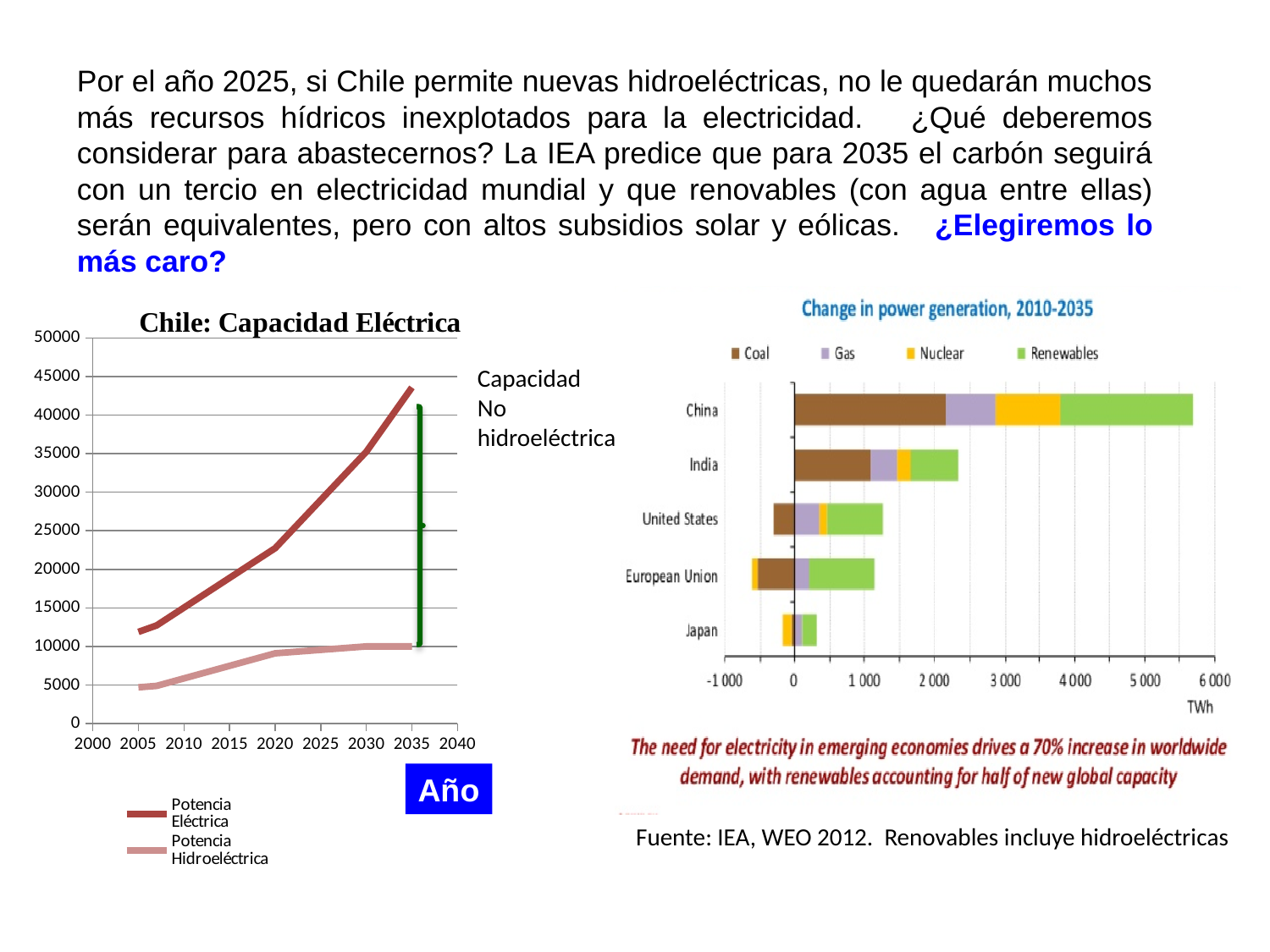
How many series does the legend of the 'Chile: Capacidad Eléctrica' chart list? 2 In the 'Chile: Capacidad Eléctrica' chart, is the value of Potencia Eléctrica in 2035 greater or less than 40000? greater What kind of chart is the 'Change in power generation, 2010-2035' chart? stacked bar chart How many countries or regions are shown in the 'Change in power generation, 2010-2035' chart? 5 In the 'Chile: Capacidad Eléctrica' chart, does Potencia Eléctrica rise or fall from 2005 to 2035? rise What kind of chart is the 'Chile: Capacidad Eléctrica' chart? line chart How many series does the legend of the 'Change in power generation, 2010-2035' chart list? 4 In the 'Change in power generation, 2010-2035' chart, which country or region has the largest total change? China In the 'Chile: Capacidad Eléctrica' chart, is the value of Potencia Hidroeléctrica in 2035 greater or less than 15000? less In the 'Chile: Capacidad Eléctrica' chart, which series has the higher value in 2035, Potencia Eléctrica or Potencia Hidroeléctrica? Potencia Eléctrica In the 'Change in power generation, 2010-2035' chart, is the total change for China greater or less than 5 000 TWh? greater